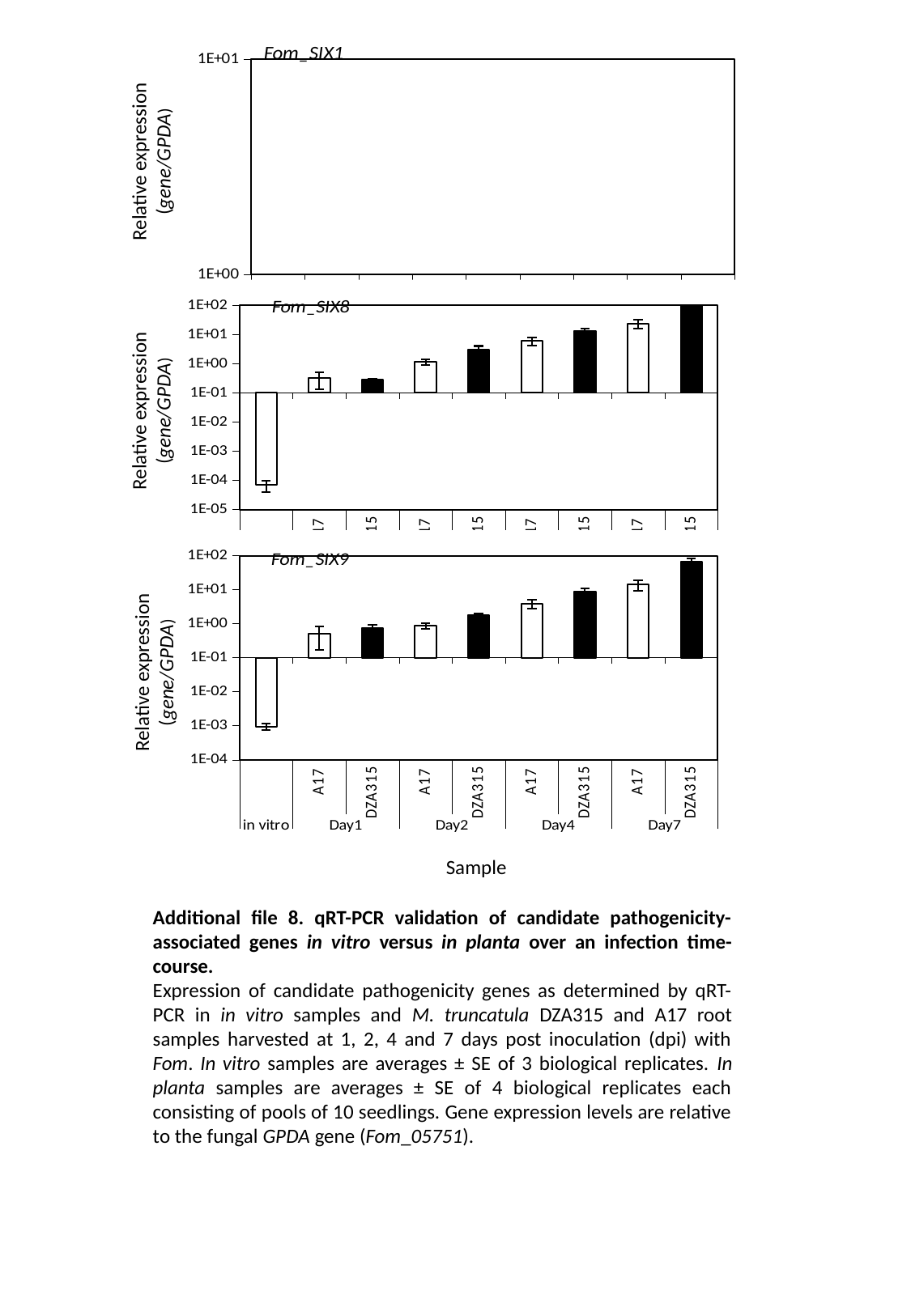
In the Fom_SIX9 chart, which sample has the highest relative expression? Day7 DZA315 In the Fom_SIX8 chart, is the value for Day7 A17 greater or less than 1E+01? greater In the Fom_SIX9 chart, is the value for Day7 DZA315 greater or less than 1E+01? greater In the Fom_SIX8 chart, do the in planta values rise or fall from Day1 to Day7? rise What kind of chart is the Fom_SIX8 chart? bar chart In the Fom_SIX8 chart, which sample has the lowest relative expression? in vitro What is the x-axis title shown below the charts? Sample In the Fom_SIX8 chart, is the value for Day2 DZA315 greater or less than 1E+00? greater In the Fom_SIX9 chart, which sample has the lowest relative expression? in vitro How many bars are plotted in the Fom_SIX9 chart? 9 In the Fom_SIX9 chart, which is larger at Day7: A17 or DZA315? DZA315